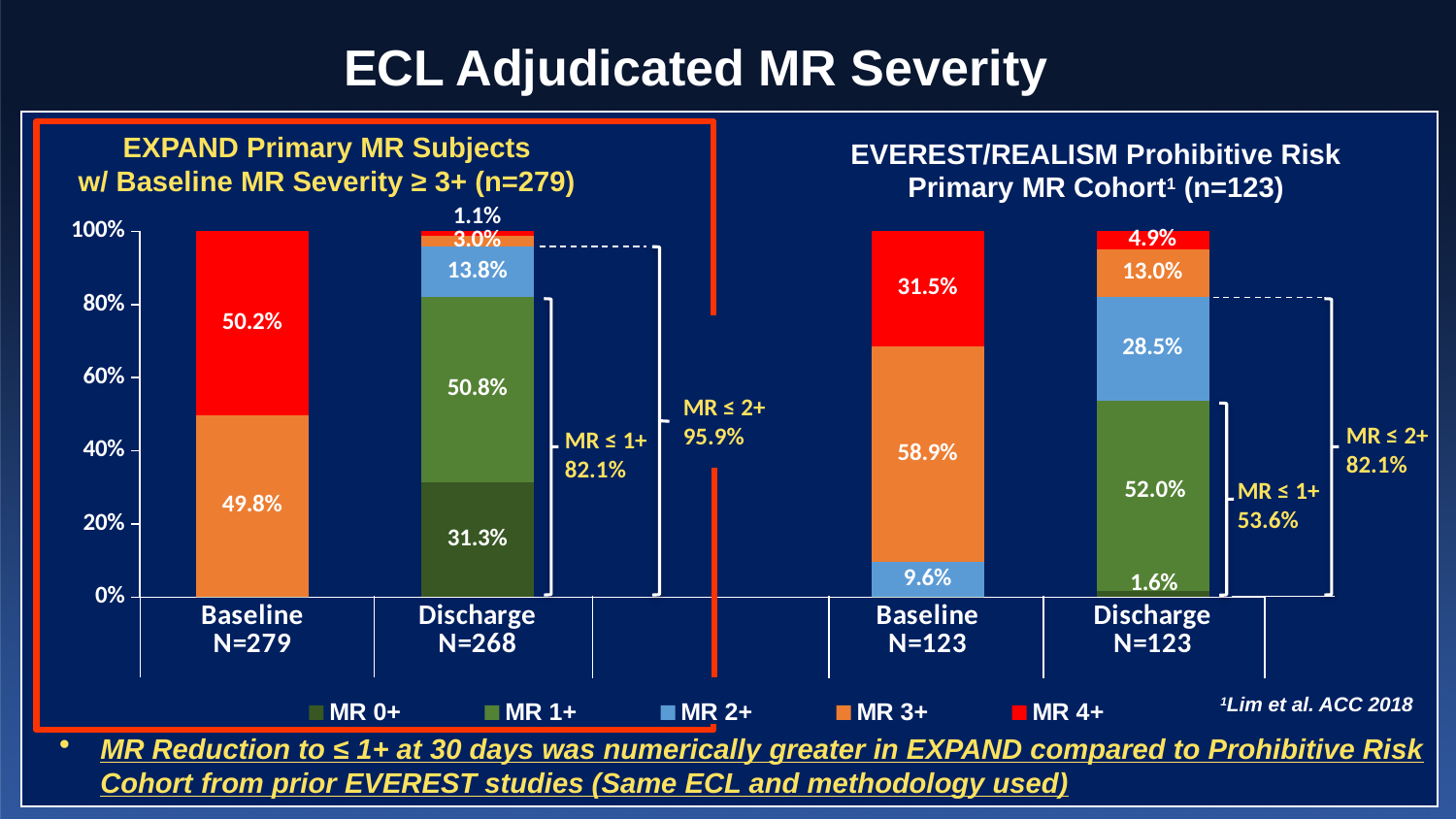
What kind of chart is used on this slide? Stacked bar chart How many series does the legend list? 5 In the EVEREST/REALISM chart on the right, what percentage of subjects had MR 3+ at Baseline? 58.9% In the EXPAND chart on the left, what percentage of subjects had MR 1+ at Discharge? 50.8% In the EXPAND chart on the left, which MR severity category has the largest share of the Discharge bar? MR 1+ In the EXPAND chart on the left, what is the combined MR ≤ 2+ share at Discharge shown by the bracket annotation? 95.9% Which chart shows a larger MR 0+ share at Discharge, the EXPAND chart on the left or the EVEREST/REALISM chart on the right? EXPAND chart on the left In the EVEREST/REALISM chart on the right, which MR severity category has the smallest share of the Discharge bar? MR 0+ In the EXPAND chart on the left, what is the difference between the MR 1+ and MR 0+ shares at Discharge? 19.5% In the EXPAND chart on the left, what percentage of subjects had MR 4+ at Baseline? 50.2% In the EVEREST/REALISM chart on the right, what percentage of subjects had MR 2+ at Discharge? 28.5% In the EVEREST/REALISM chart on the right, what is the N for the Discharge bar? N=123